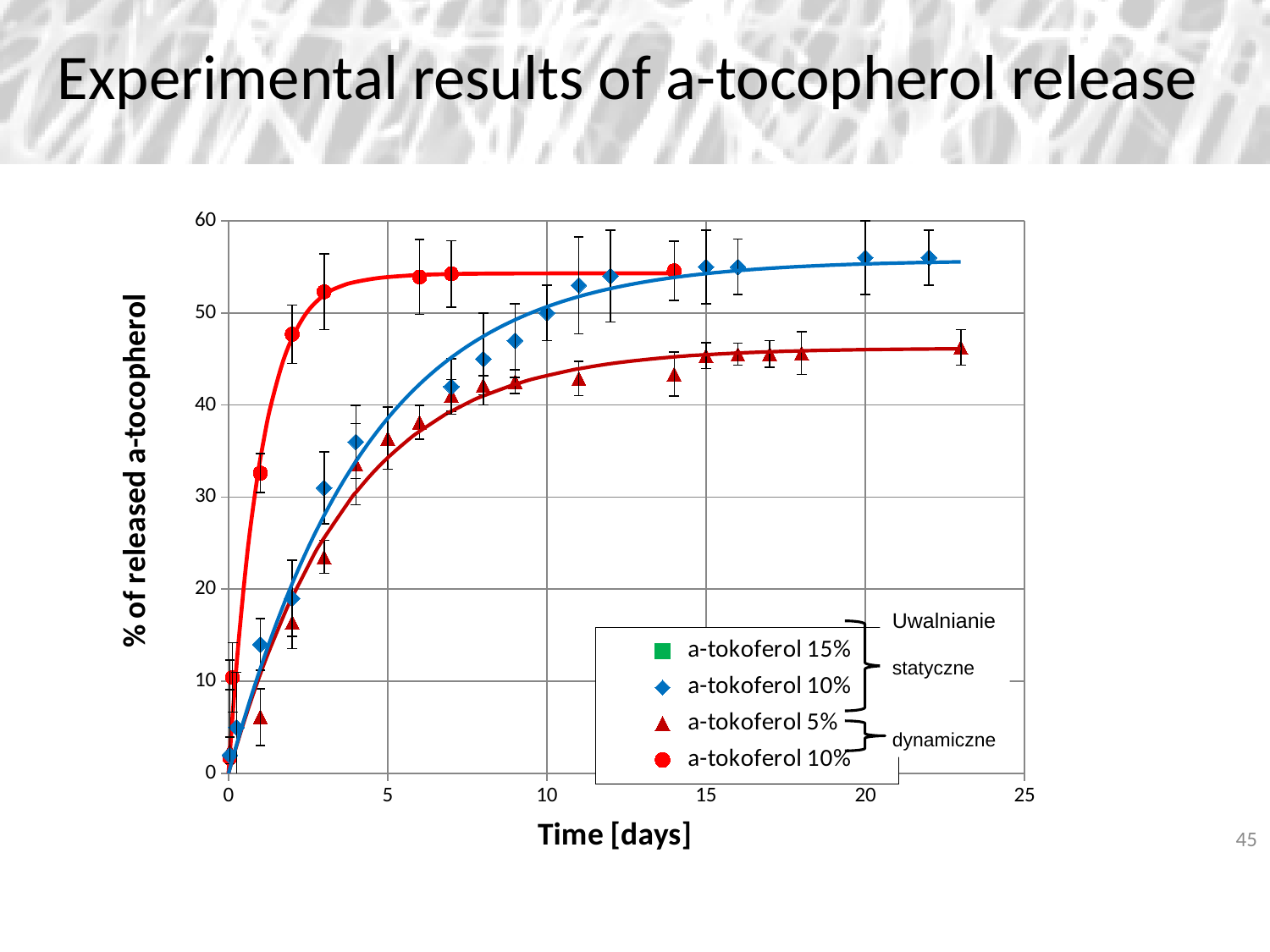
Is the value of the a-tokoferol 5% (red triangle) series at day 23 greater or less than 50? less Do the values of the a-tokoferol 5% (red triangle) series rise or fall as time increases? Rise What is the title of the x axis of the chart? Time [days] What kind of chart is shown on the slide? Scatter chart with fitted curves Is the value of the red circle a-tokoferol 10% series at day 3 greater or less than 50? greater At day 5, which is larger: the red circle a-tokoferol 10% series or the a-tokoferol 5% (red triangle) series? Red circle a-tokoferol 10% What is the title of the y axis of the chart? % of released a-tocopherol Is the value of the blue diamond a-tokoferol 10% series at day 2 greater or less than 20? less At day 20, which is larger: the blue diamond a-tokoferol 10% series or the a-tokoferol 5% (red triangle) series? Blue diamond a-tokoferol 10% How many series does the chart legend list? 4 Which plotted series levels off at the lowest percentage of released a-tocopherol? a-tokoferol 5% (red triangle)